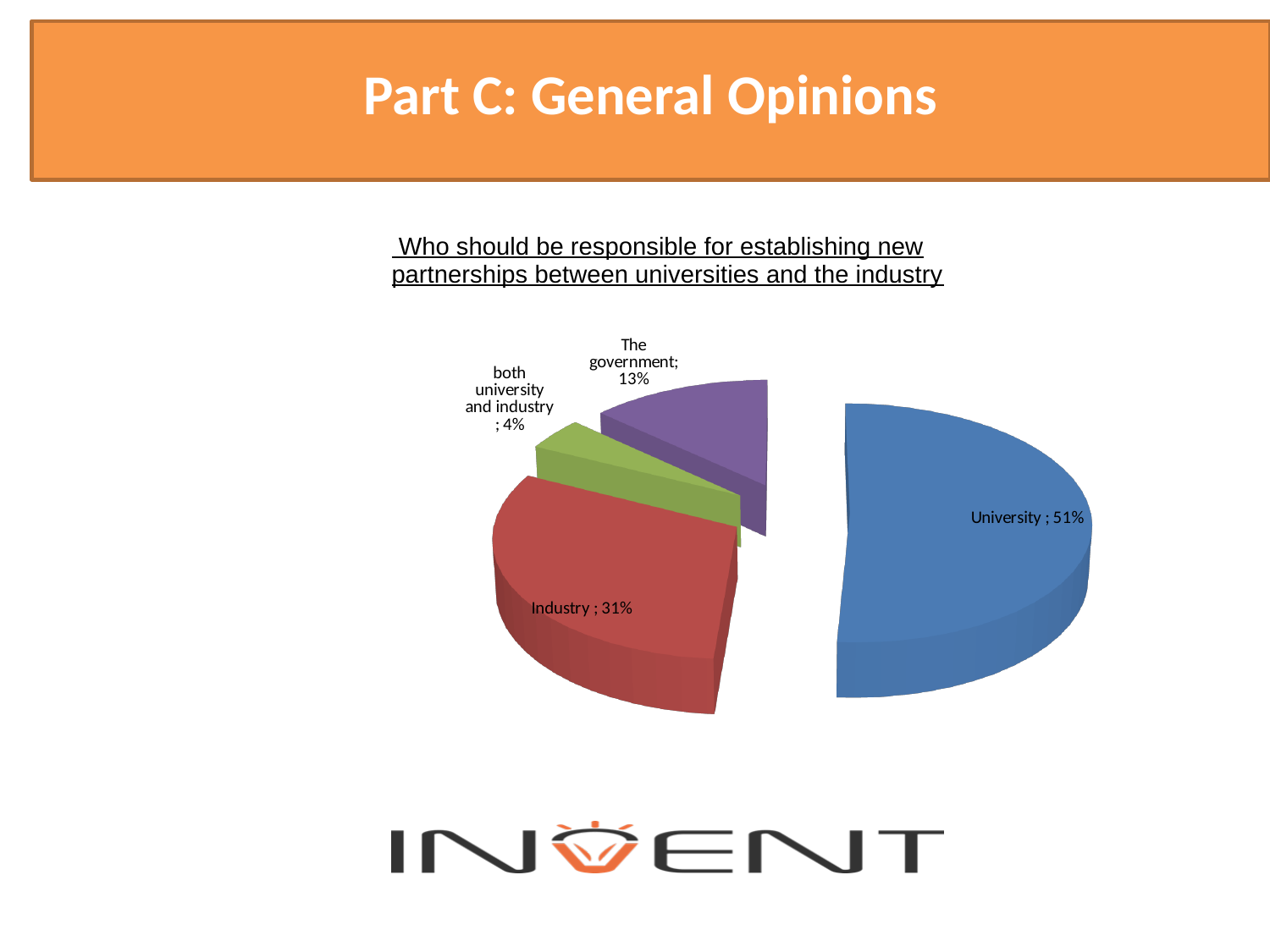
What is the difference in percentage points between the University and Industry slices? 20 What share of the pie is labelled for The government? 13% How many slices does the pie chart have? 4 What colour is the University slice? Blue What share of the pie is labelled for University? 51% What share of the pie is labelled for both university and industry? 4% Which category has the smallest slice of the pie? both university and industry Which category has the largest slice of the pie? University Which slice is larger, The government or Industry? Industry What kind of chart is shown on the slide? Pie chart What share of the pie is labelled for Industry? 31% What is the title of the chart? Who should be responsible for establishing new partnerships between universities and the industry